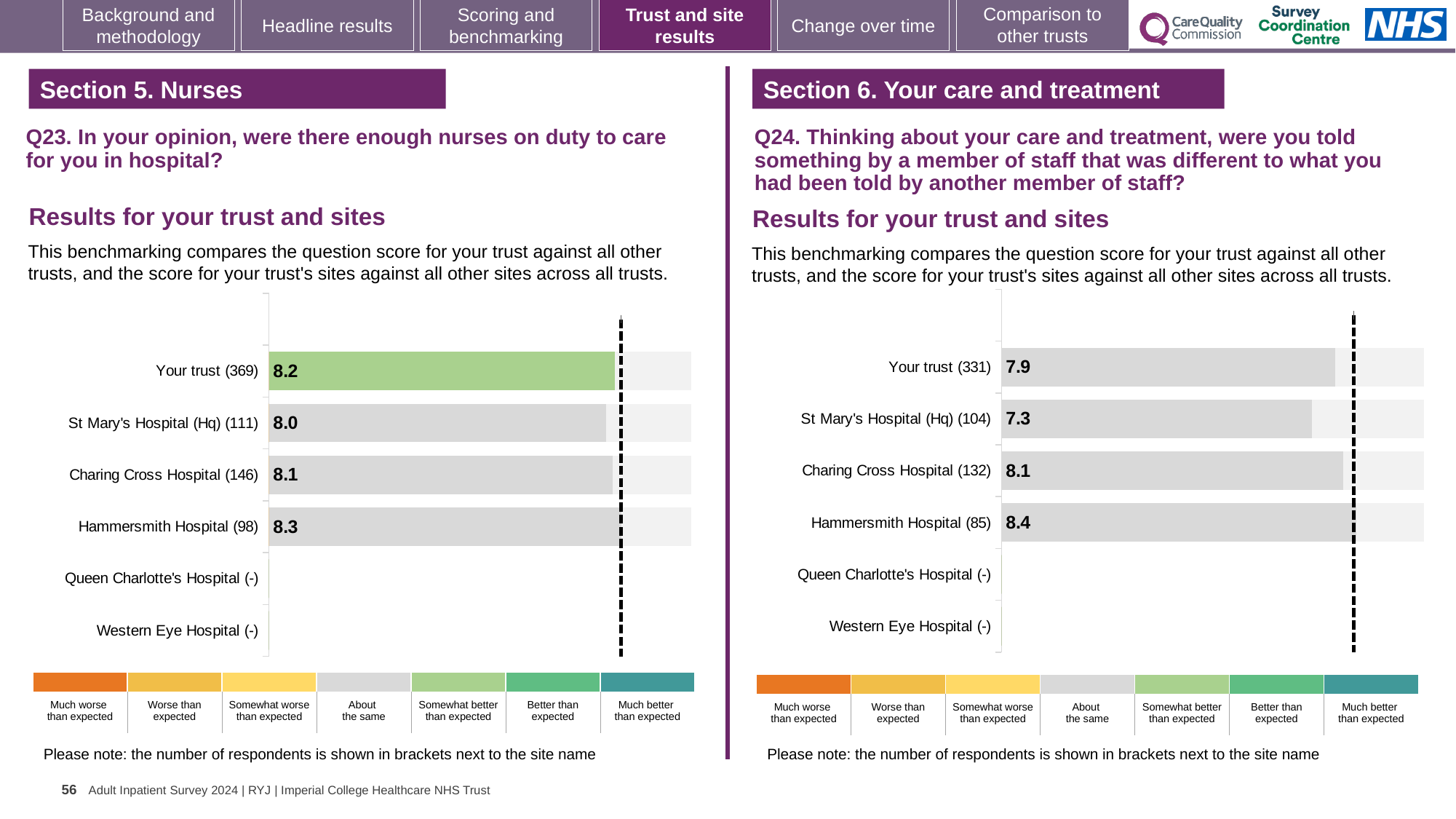
In the Q24 chart on the right, what is the score for Hammersmith Hospital? 8.4 In the Q23 chart on the left, what is the difference between the scores for Hammersmith Hospital and St Mary's Hospital (Hq)? 0.3 In the Q24 chart on the right, what is the difference between the scores for Hammersmith Hospital and Your trust? 0.5 In the Q24 chart on the right, which site has the lowest score? St Mary's Hospital (Hq) In the Q24 chart on the right, is the score for Charing Cross Hospital or St Mary's Hospital (Hq) larger? Charing Cross Hospital In the Q24 chart on the right, what is the score for Your trust? 7.9 What kind of chart is used for the Q23 results on the left? Bar chart In the Q23 chart on the left, what is the score for St Mary's Hospital (Hq)? 8.0 In the Q23 chart on the left, which site has the highest score? Hammersmith Hospital In the Q23 chart on the left, how many respondents are shown for Charing Cross Hospital? 146 In the Q23 chart on the left, which benchmark category does the green colour of the Your trust bar correspond to? Somewhat better than expected In the Q23 chart on the left, what is the score for Your trust? 8.2